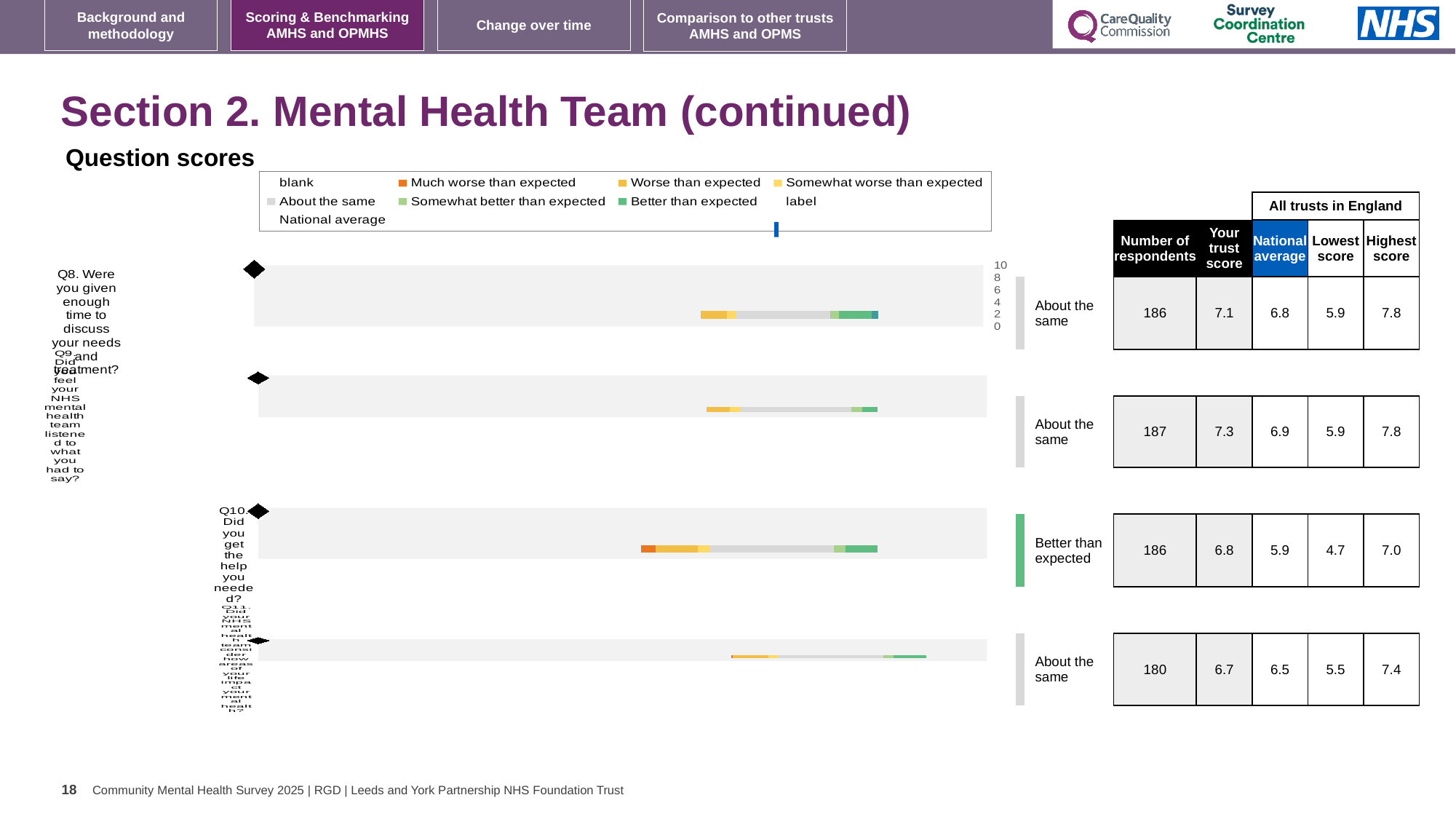
Which question is rated 'Better than expected' in the chart's category labels? Q10 Which question has the lowest number of respondents in the table beside the chart? Q11 In the table beside the chart, how many respondents answered Q11? 180 In the table beside the chart, what is the highest score among all trusts in England for Q10 (Did you get the help you needed?)? 7.0 Which question has the highest 'Your trust score' in the table beside the chart? Q9 What is the difference between the trust score and the national average for Q8 in the table beside the chart? 0.3 For Q10, which is larger in the table beside the chart: the trust score or the national average? the trust score In the table beside the chart, what is the 'Your trust score' for Q8 (Were you given enough time to discuss your needs and treatment?)? 7.1 How many questions (bars) are plotted in the question scores chart? 4 In the table beside the chart, what is the national average for Q9 (Did you feel your NHS mental health team listened to what you had to say?)? 6.9 What is the maximum value shown on the chart's score axis? 10 What kind of chart is used to show the question scores on this slide? bar chart